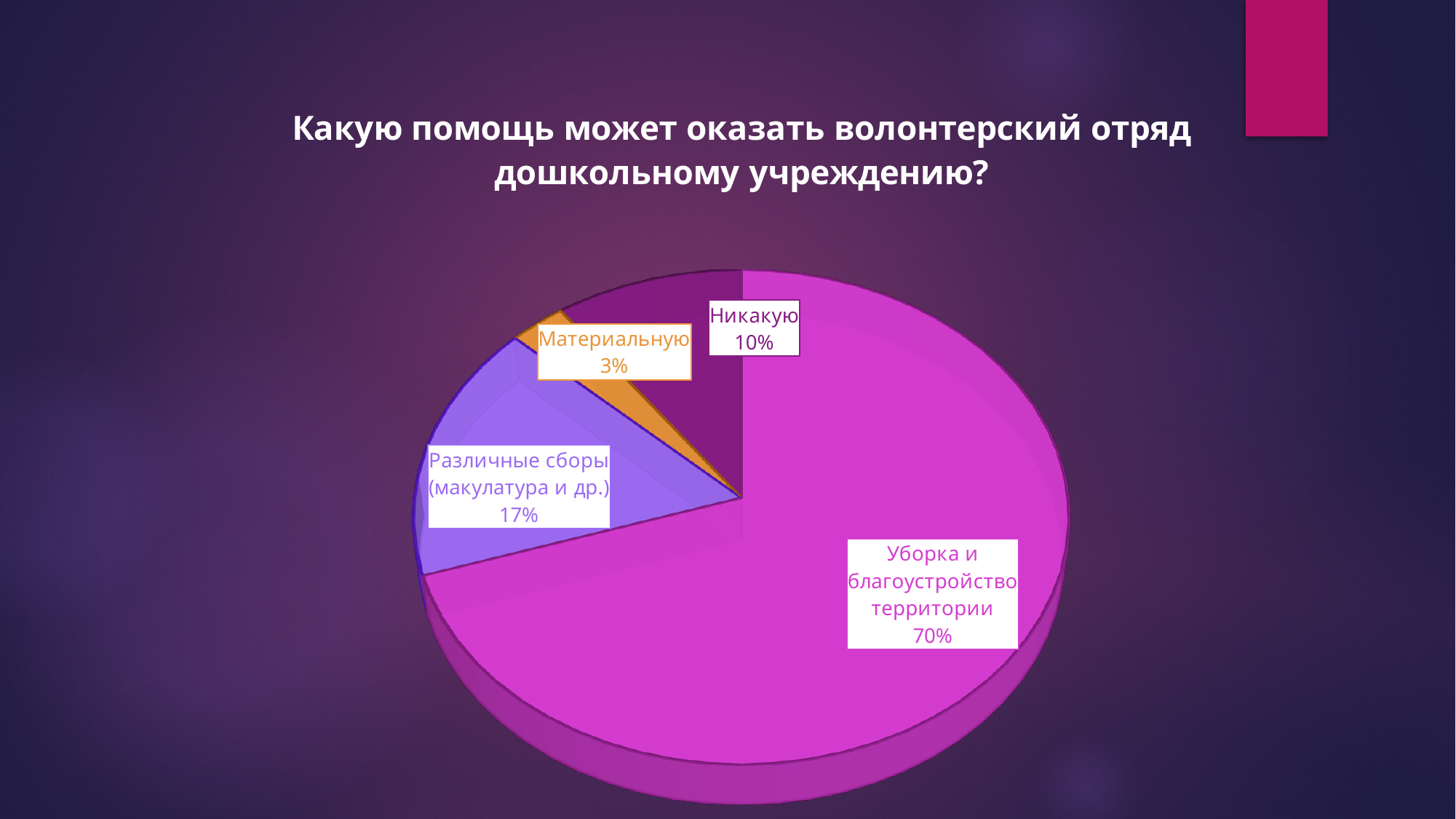
Which category has the largest slice of the pie? Уборка и благоустройство территории What is the value shown for "Материальную"? 3% What is the title of the chart? Какую помощь может оказать волонтерский отряд дошкольному учреждению? What is the value shown for "Никакую"? 10% What is the difference between the shares for "Уборка и благоустройство территории" and "Различные сборы (макулатура и др.)"? 53% What is the value shown for "Различные сборы (макулатура и др.)"? 17% Which is larger: the share for "Никакую" or the share for "Различные сборы (макулатура и др.)"? Различные сборы (макулатура и др.) Which category has the smallest slice of the pie? Материальную What kind of chart is shown on the slide? Pie chart What share of the pie does "Уборка и благоустройство территории" take? 70% What is the difference between the shares for "Никакую" and "Материальную"? 7% How many slices does the pie chart have? 4